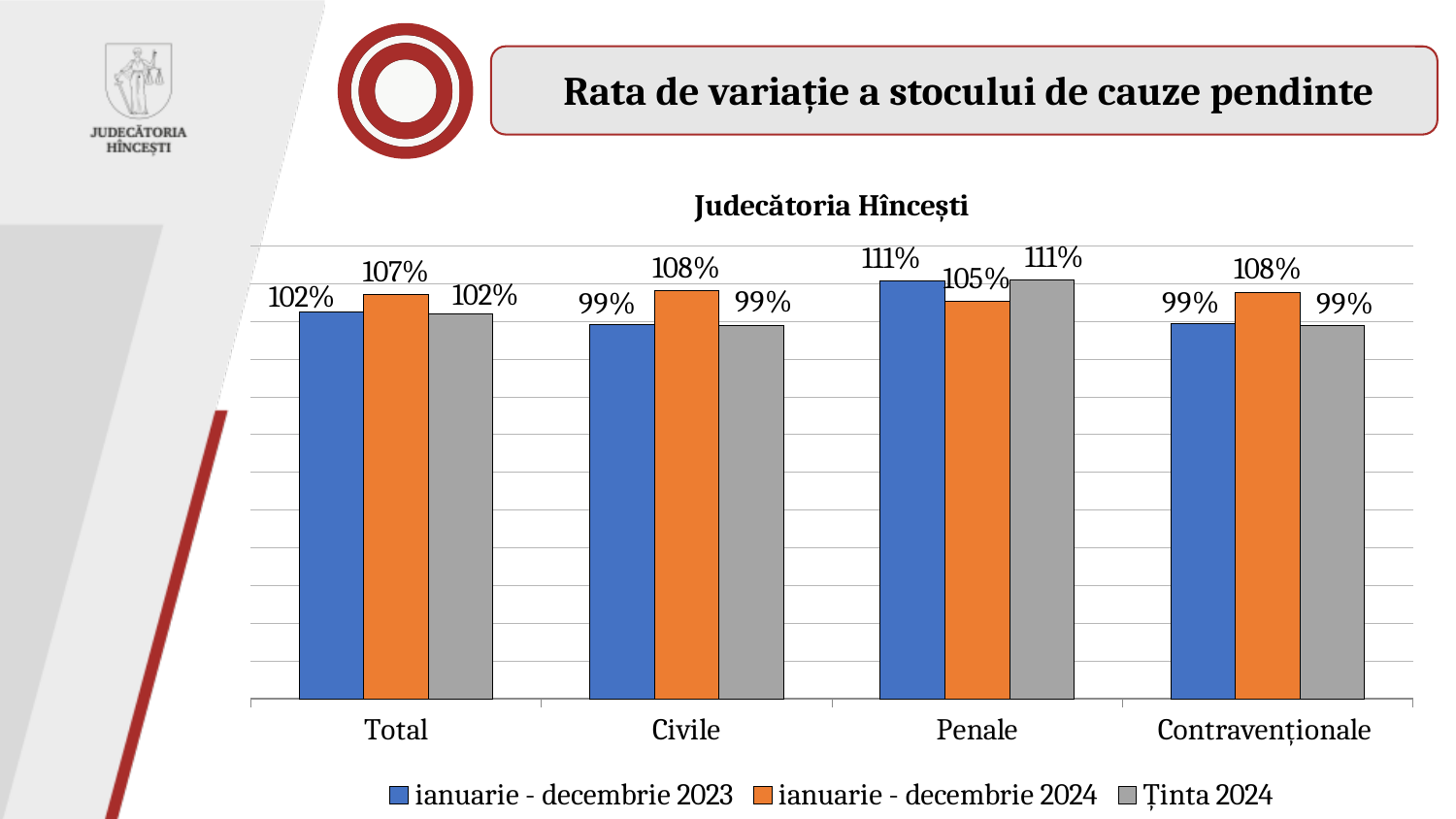
What is the value for Contravenționale in the 'ianuarie - decembrie 2024' series? 108% Which category has the highest value in the 'ianuarie - decembrie 2023' series? Penale How many categories are shown on the x axis? 4 Which category has the lowest value in the 'ianuarie - decembrie 2024' series? Penale For Penale, which is larger: the 'ianuarie - decembrie 2023' value or the 'ianuarie - decembrie 2024' value? ianuarie - decembrie 2023 What is the value for Penale in the 'ianuarie - decembrie 2023' series? 111% What kind of chart is shown on the slide? Bar chart What is the title of the chart? Judecătoria Hîncești How many series does the legend list? 3 What is the value for Civile in the 'ianuarie - decembrie 2024' series? 108% What is the difference between the 'ianuarie - decembrie 2024' value and the 'ianuarie - decembrie 2023' value for Civile? 9% What is the 'Ținta 2024' value for Total? 102%